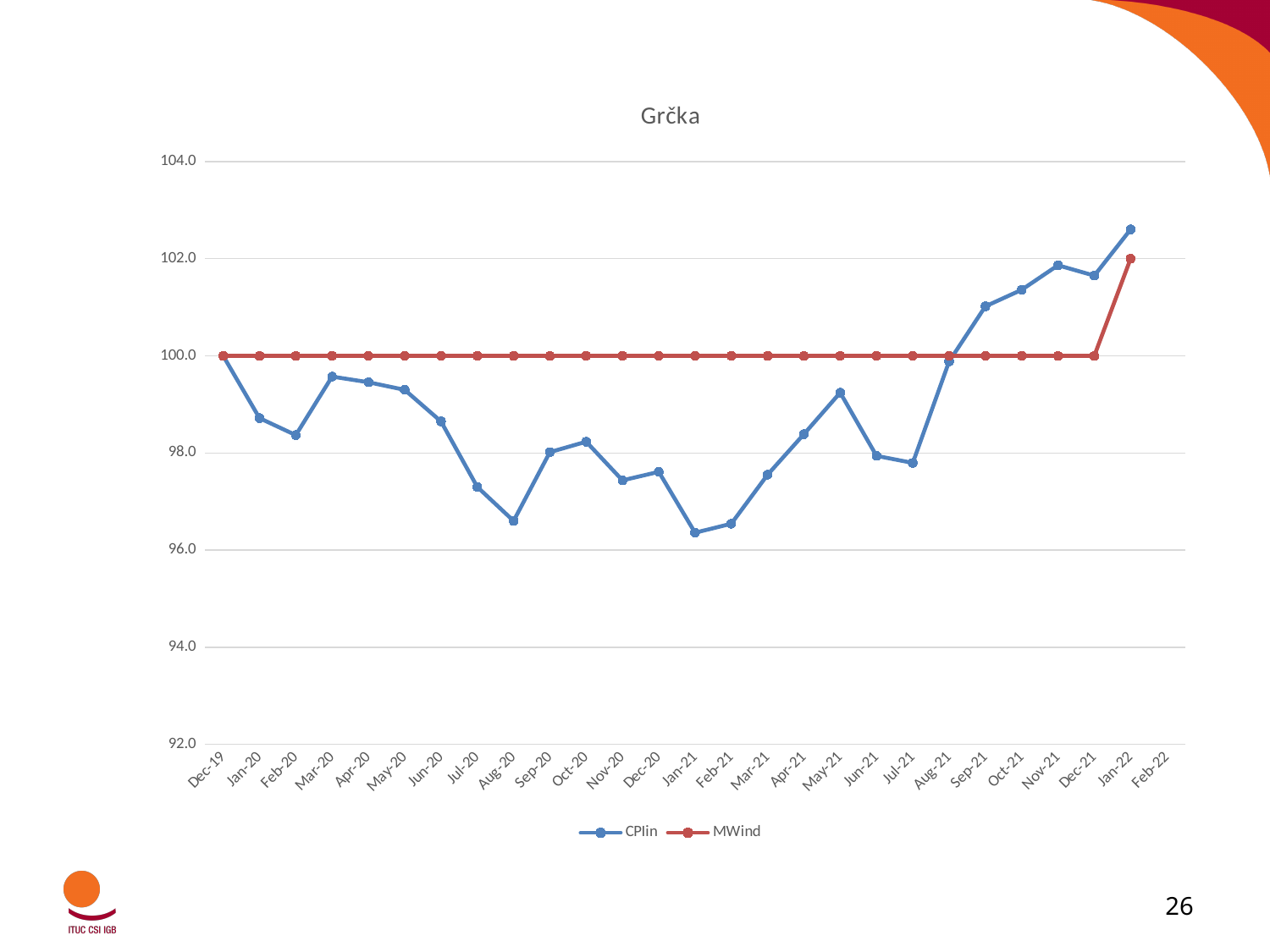
In which month does CPIin reach its highest value? Jan-22 What is the value of MWind in Jun-20? 100.0 What is the value of MWind in Jan-22? 102.0 How many series does the legend list? 2 Is the value of CPIin in Aug-20 greater or less than 98.0? less What kind of chart is shown on the slide? line chart Is the value of CPIin in Jan-21 greater or less than 98.0? less In Mar-21, which series has the higher value, CPIin or MWind? MWind What is the title of the chart? Grčka Is the value of CPIin in Jan-22 greater or less than 102.0? greater What is the value of CPIin in Dec-19? 100.0 In Sep-21, which series has the higher value, CPIin or MWind? CPIin